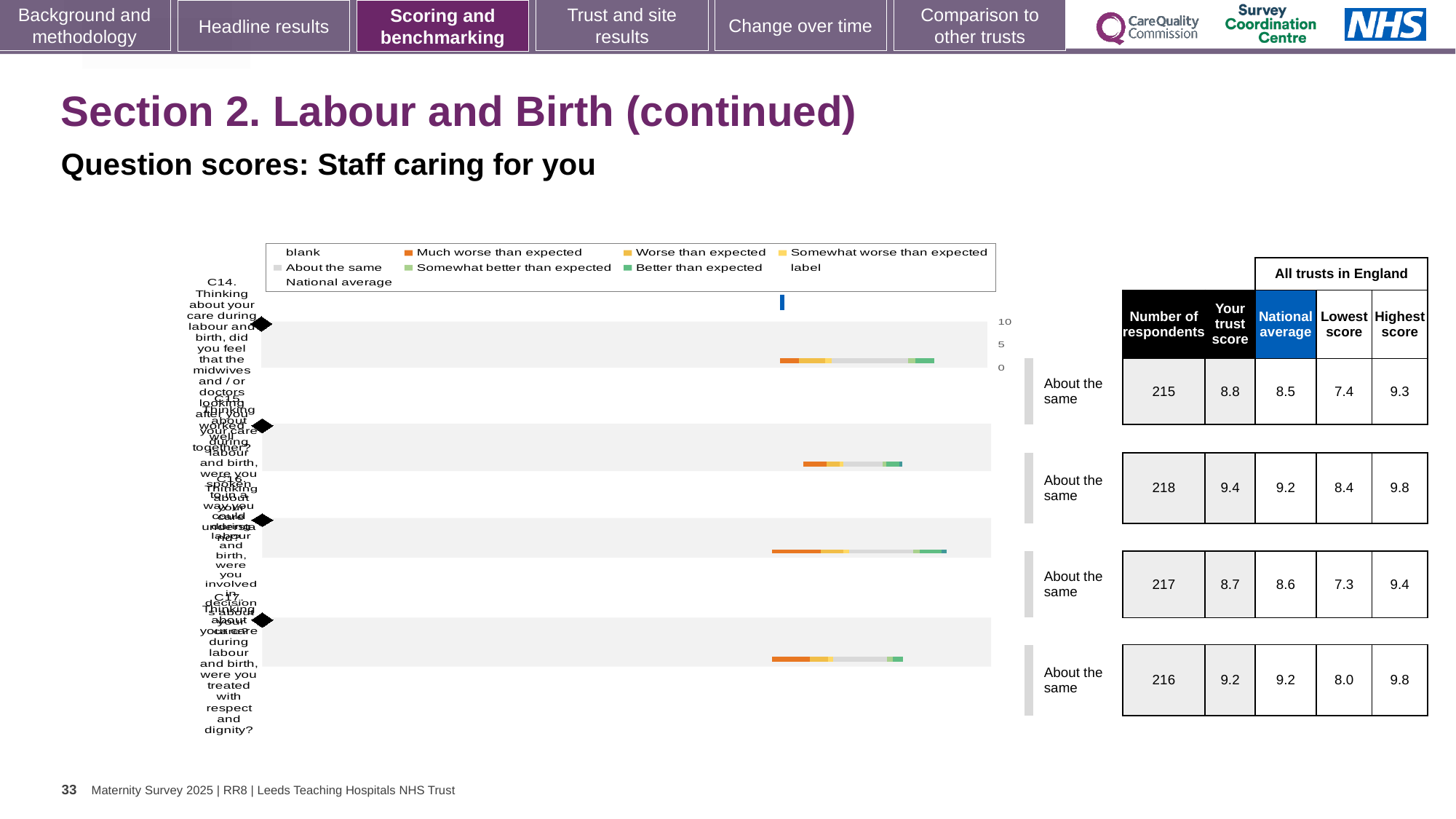
What benchmark label is shown for each of the four question rows? About the same In the table beside the chart, what is the number of respondents for the second row (C15)? 218 In the table beside the chart, what is the difference between the highest score and the lowest score for the top row (C14)? 1.9 In the table beside the chart, which row has the highest 'Your trust score', and what is it? Second row (C15), 9.4 How many question rows (bars) are plotted in the chart? 4 In the table beside the chart, what is 'Your trust score' for the top row (C14)? 8.8 In the table beside the chart, for the third row (C16), which is larger: 'Your trust score' or the 'National average'? Your trust score How many entries does the chart legend list? 9 In the chart legend, what colour represents 'Much worse than expected'? orange What kind of chart is shown on the slide? bar chart In the table beside the chart, what is the lowest value in the 'Lowest score' column? 7.3